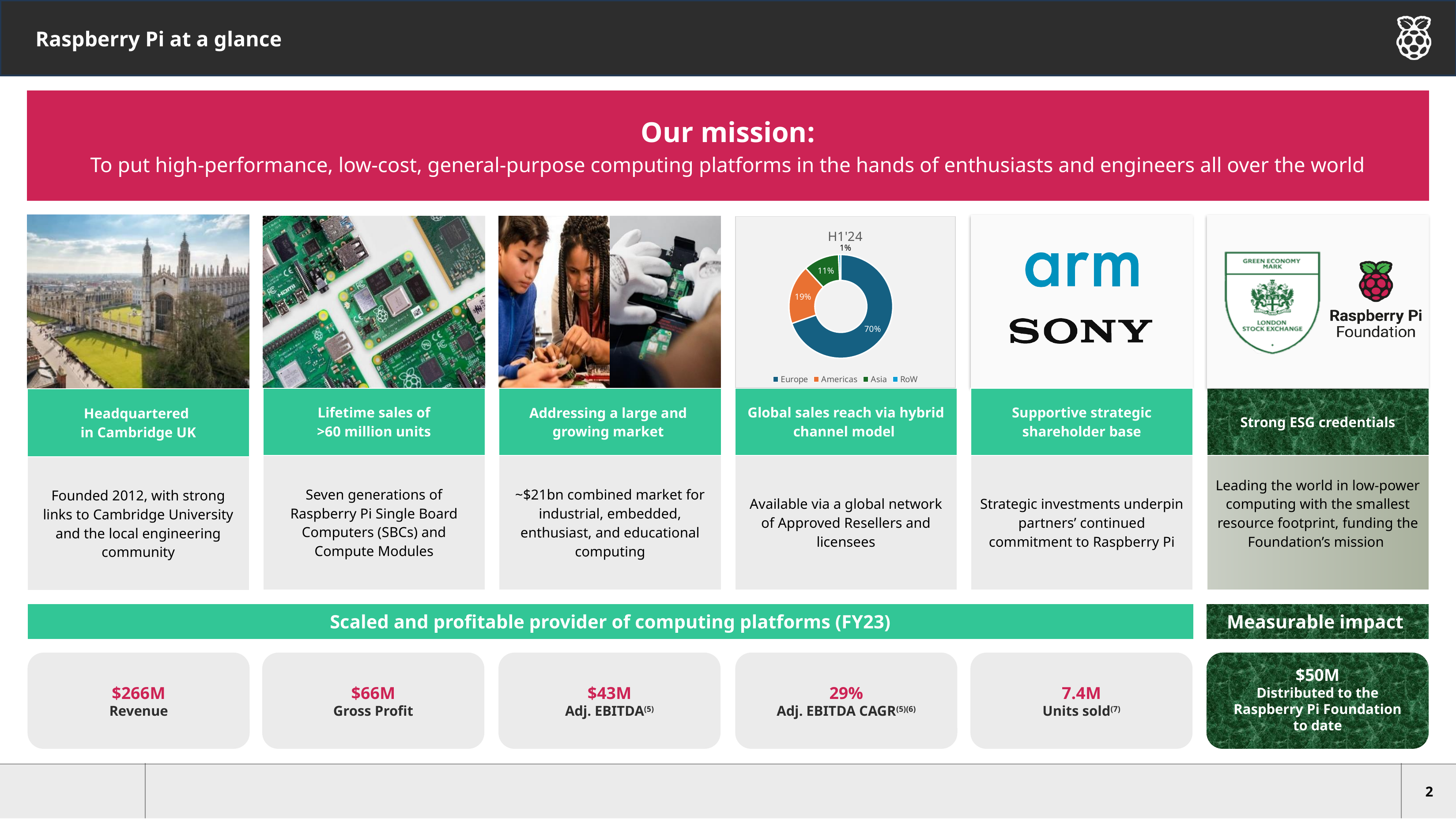
Which region has the largest share in the H1'24 donut chart? Europe In the H1'24 donut chart, what share does RoW account for? 1% In the H1'24 donut chart, what share does Europe account for? 70% What entries does the legend of the H1'24 donut chart list? Europe, Americas, Asia, RoW What kind of chart is shown under the 'Global sales reach via hybrid channel model' heading? Donut (pie) chart In the H1'24 donut chart, which is larger: the share for Americas or the share for Asia? Americas What is the title of the donut chart on the slide? H1'24 In the H1'24 donut chart, what share does Americas account for? 19% How many regions are shown in the H1'24 donut chart? 4 In the H1'24 donut chart, how many percentage points larger is Europe's share than Americas' share? 51 In the H1'24 donut chart, what share does Asia account for? 11% Which region has the smallest share in the H1'24 donut chart? RoW